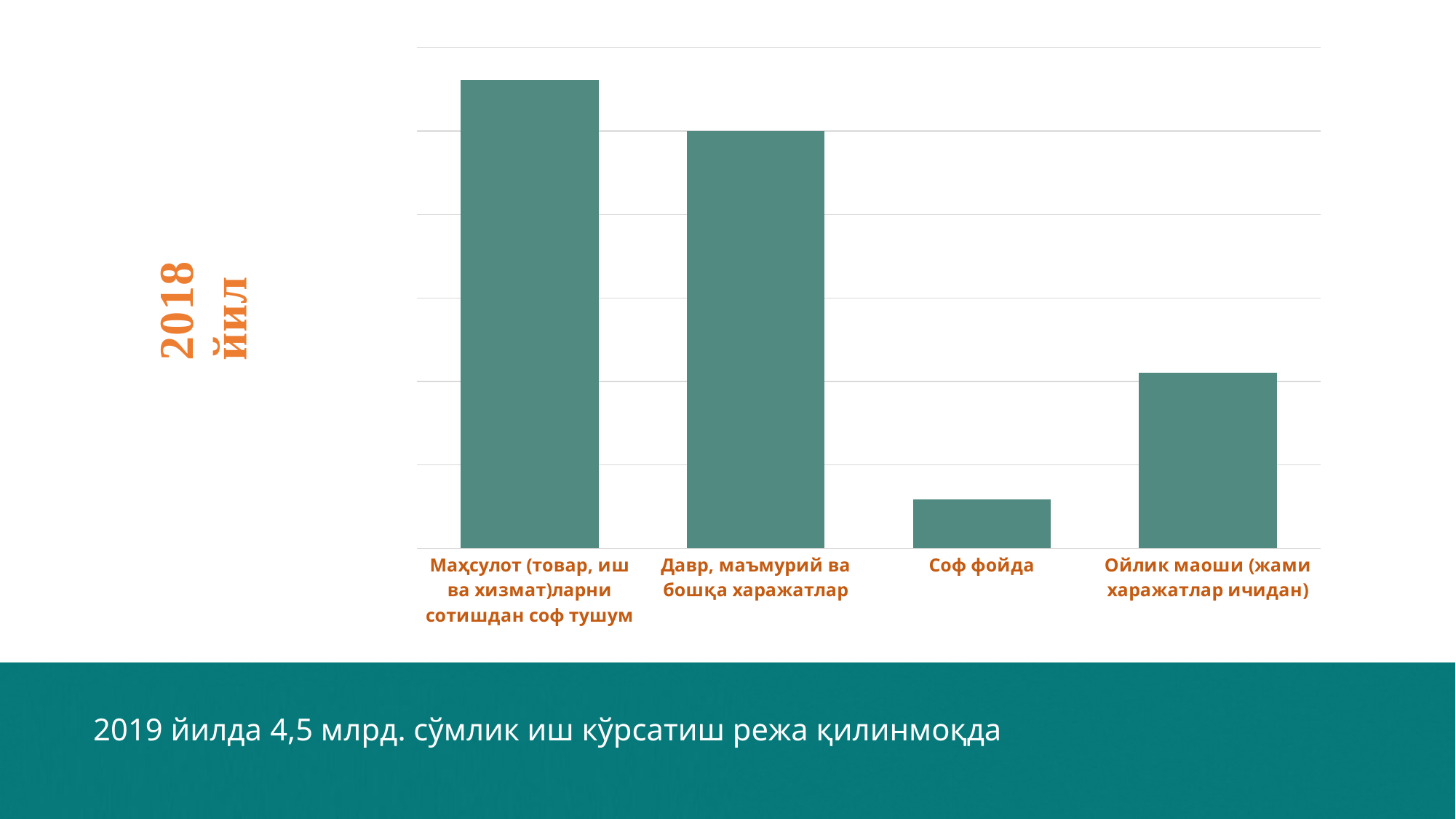
Which is larger: the bar for Давр, маъмурий ва бошқа харажатлар or the bar for Ойлик маоши (жами харажатлар ичидан)? Давр, маъмурий ва бошқа харажатлар What year does the chart's title refer to? 2018 йил Which category has the highest bar? Маҳсулот (товар, иш ва хизмат)ларни сотишдан соф тушум Which is larger: the bar for Соф фойда or the bar for Ойлик маоши (жами харажатлар ичидан)? Ойлик маоши (жами харажатлар ичидан) What kind of chart is shown on the slide? bar chart Which is larger: the bar for Маҳсулот (товар, иш ва хизмат)ларни сотишдан соф тушум or the bar for Давр, маъмурий ва бошқа харажатлар? Маҳсулот (товар, иш ва хизмат)ларни сотишдан соф тушум Which category has the lowest bar? Соф фойда Do the bar values rise or fall from the first category to the third category along the x axis? fall How many categories are plotted in the chart? 4 What colour are the bars in the chart? teal green